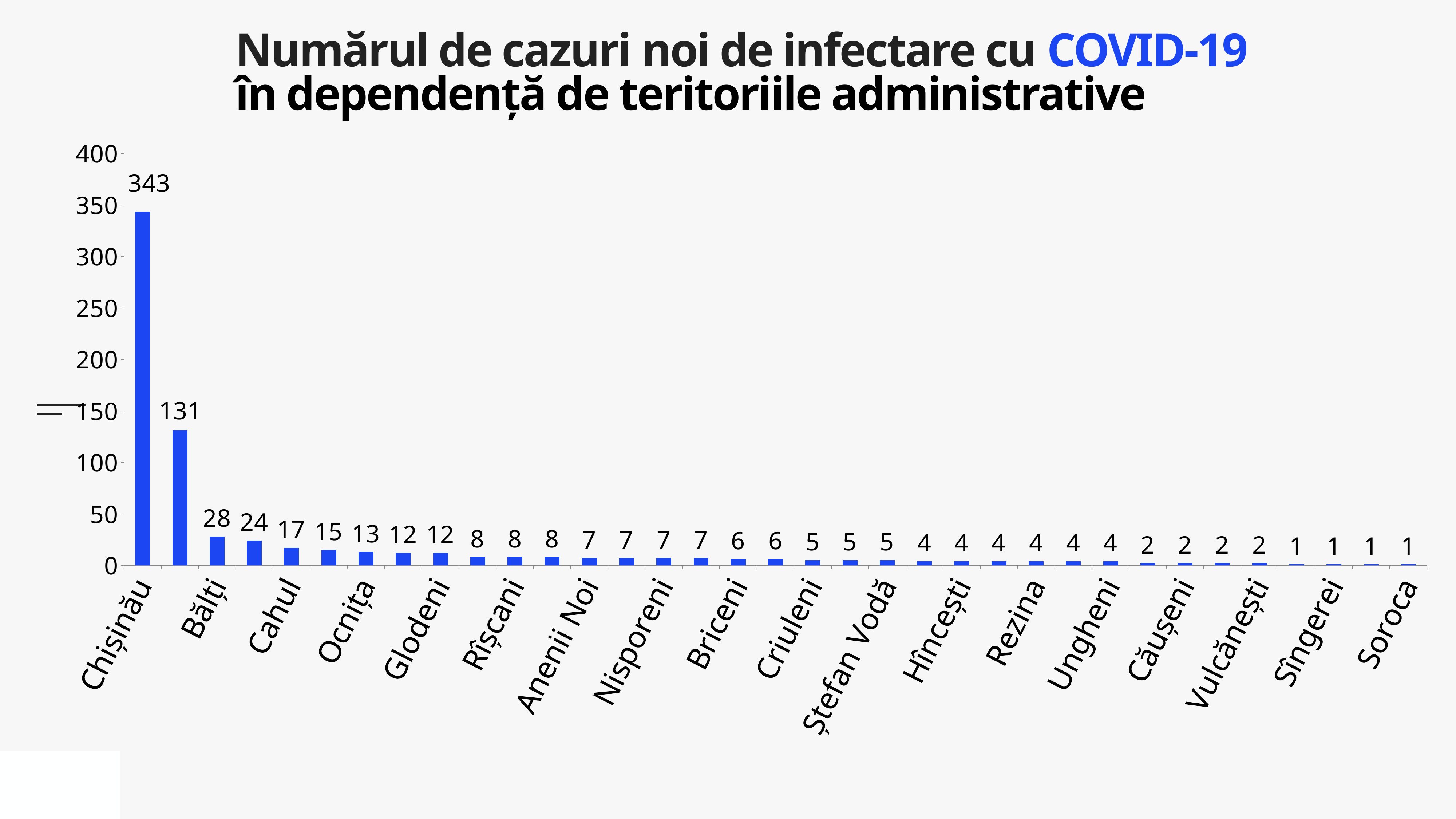
Is the value for Chișinău greater or less than 300? greater What is the smallest value shown by any bar in the chart? 1 What type of chart is shown on the slide? bar chart What is the difference between the two tallest bars (343 and 131)? 212 What colour are the bars in the chart? blue Which administrative territory has the highest number of new COVID-19 cases? Chișinău Is the value for Soroca greater or less than 50? less What is the highest tick value shown on the vertical axis? 400 What is the value of the second-tallest bar in the chart? 131 Do the bar values rise or fall from left to right along the x axis? fall Which is larger, the bar for Chișinău or the bar for Soroca? Chișinău What is the number of new cases shown for Chișinău? 343